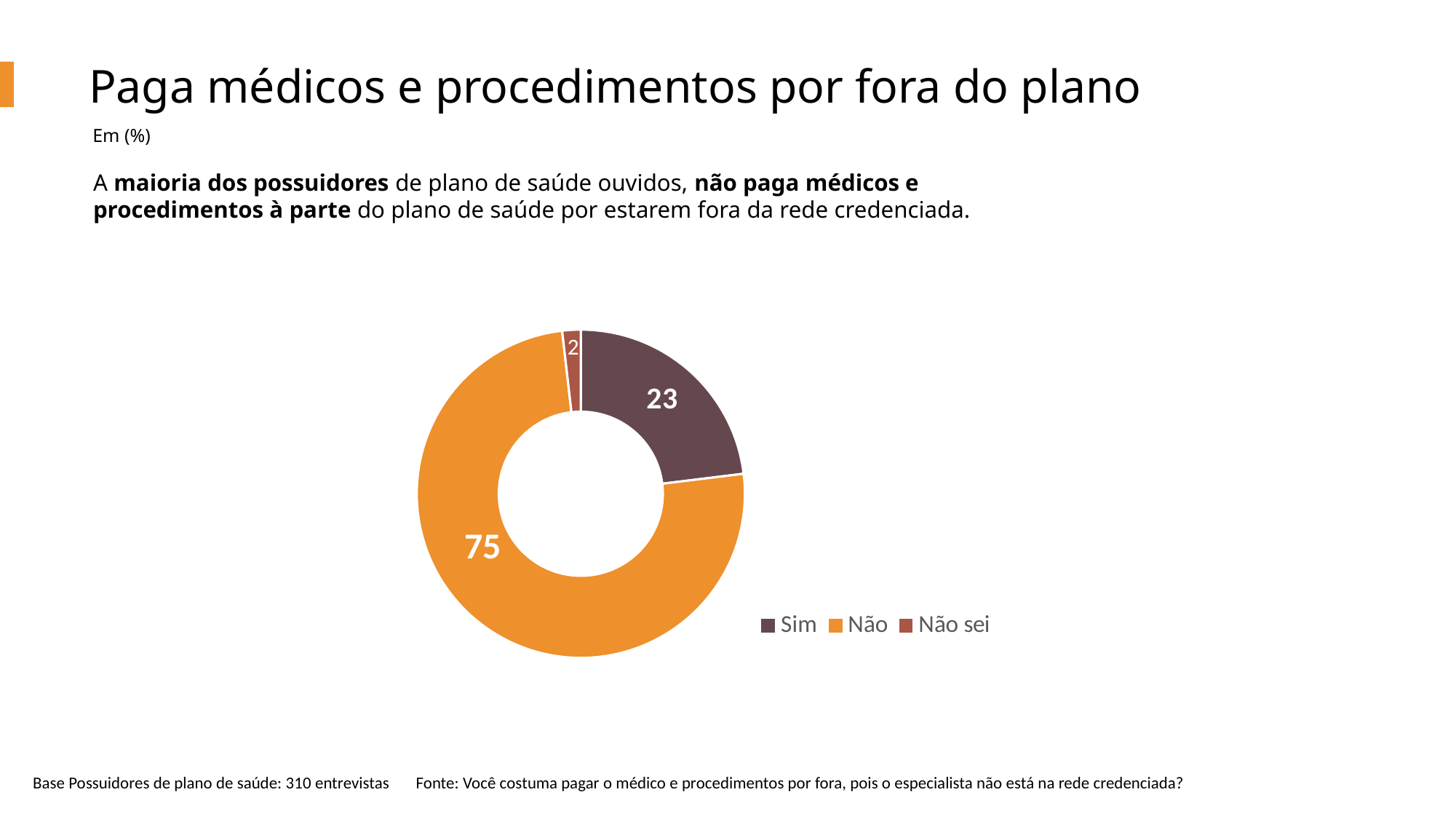
How many categories does the chart show? 3 What is the title of the slide? Paga médicos e procedimentos por fora do plano Which is larger, the value for "Sim" or the value for "Não sei"? Sim What is the value for "Não sei" in the chart? 2 What is the difference between the values for "Não" and "Sim"? 52 What is the combined value of "Sim" and "Não sei"? 25 Which colour represents "Não" in the chart? Orange Which category has the smallest share of the chart? Não sei What is the value for "Sim" in the chart? 23 What is the value for "Não" in the chart? 75 What kind of chart is shown on the slide? Doughnut chart Which category has the largest share of the chart? Não